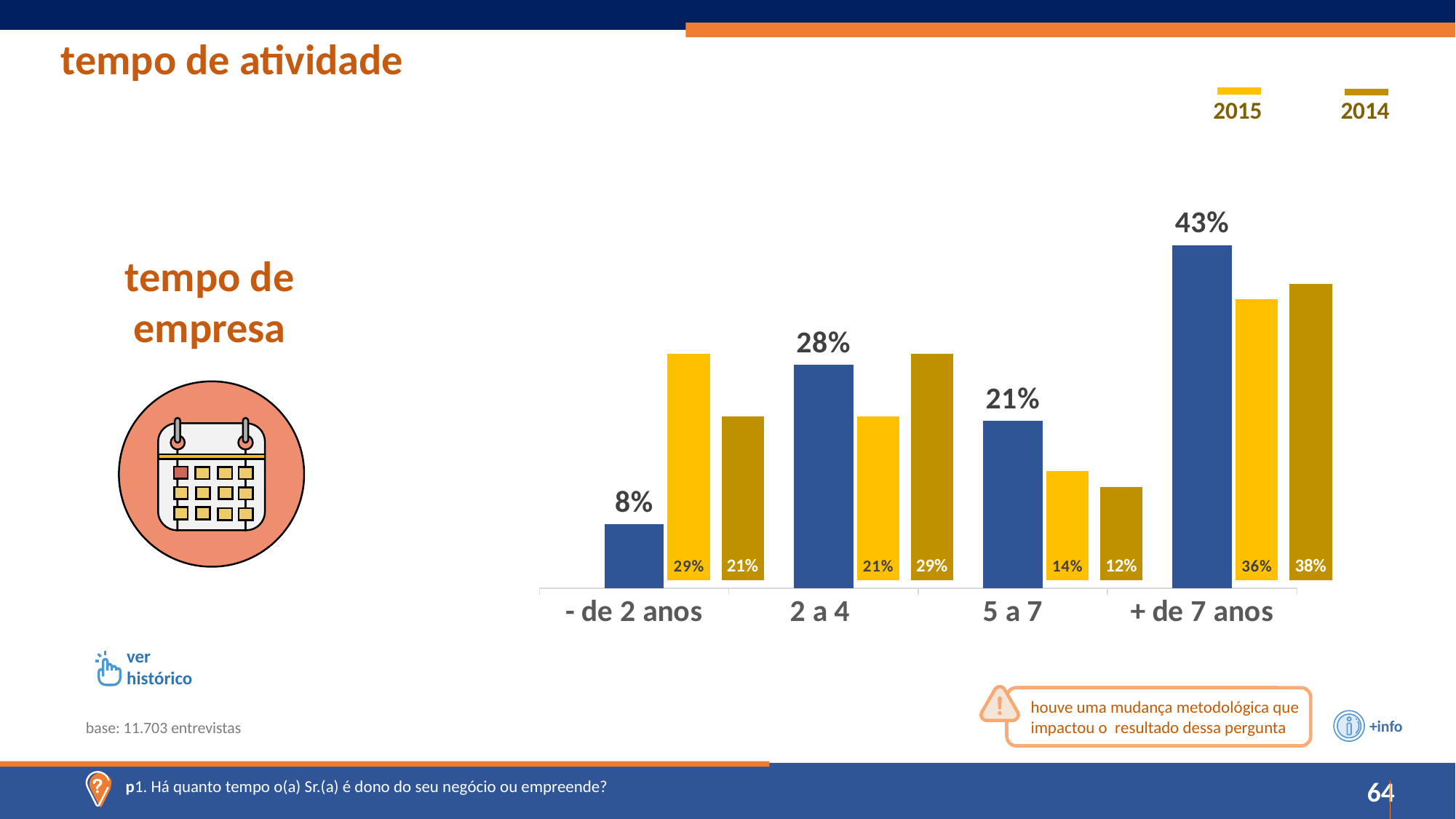
What is the value of the dark blue bar for "+ de 7 anos"? 43% What kind of chart is shown on the slide? bar chart How many series does the legend list? 2 For "2 a 4", which is larger: the 2015 value or the 2014 value? 2014 What is the 2015 value for "5 a 7"? 14% What is the title of the slide? tempo de atividade How many categories are shown on the x axis? 4 Which category has the lowest value among the dark blue bars? - de 2 anos What is the difference between the 2014 and 2015 values for "+ de 7 anos"? 2% What is the 2015 value for "- de 2 anos"? 29% What is the 2014 value for "2 a 4"? 29% Which category has the highest 2014 value? + de 7 anos